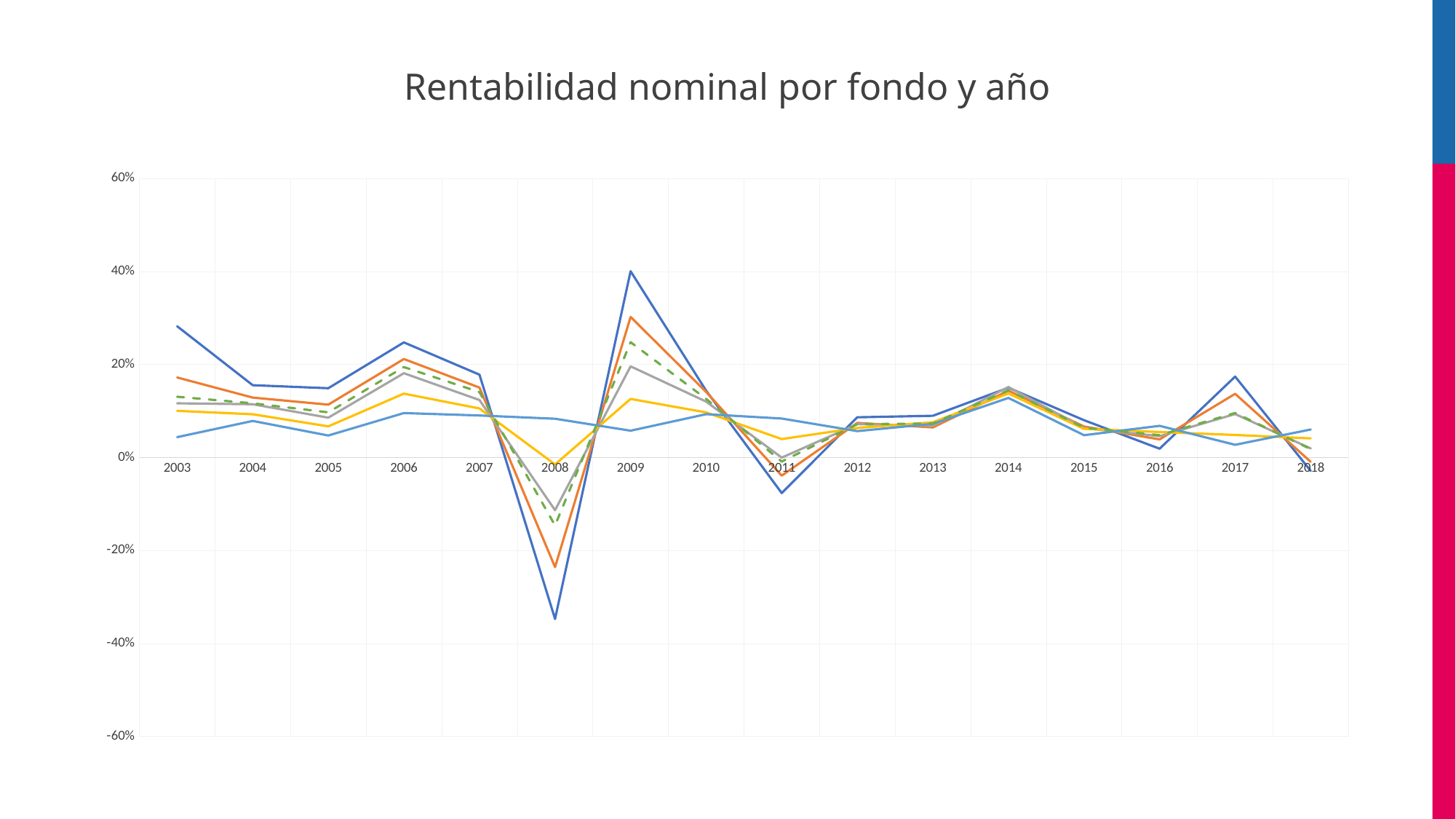
In 2008, which line has the larger value, the yellow line or the dark blue line? the yellow line Is the value of the dark blue line in 2008 greater or less than -20%? less Is the value of the dark blue line in 2009 greater or less than 20%? greater What kind of chart is shown on the slide? line chart In which year does the dark blue line reach its highest value? 2009 How many years are shown along the x axis of the chart? 16 What is the first year shown on the x axis? 2003 Is the value of the orange line in 2009 greater or less than 20%? greater What is the title of the chart? Rentabilidad nominal por fondo y año In 2003, which line has the larger value, the dark blue line or the light blue line? the dark blue line In which year does the dark blue line reach its lowest value? 2008